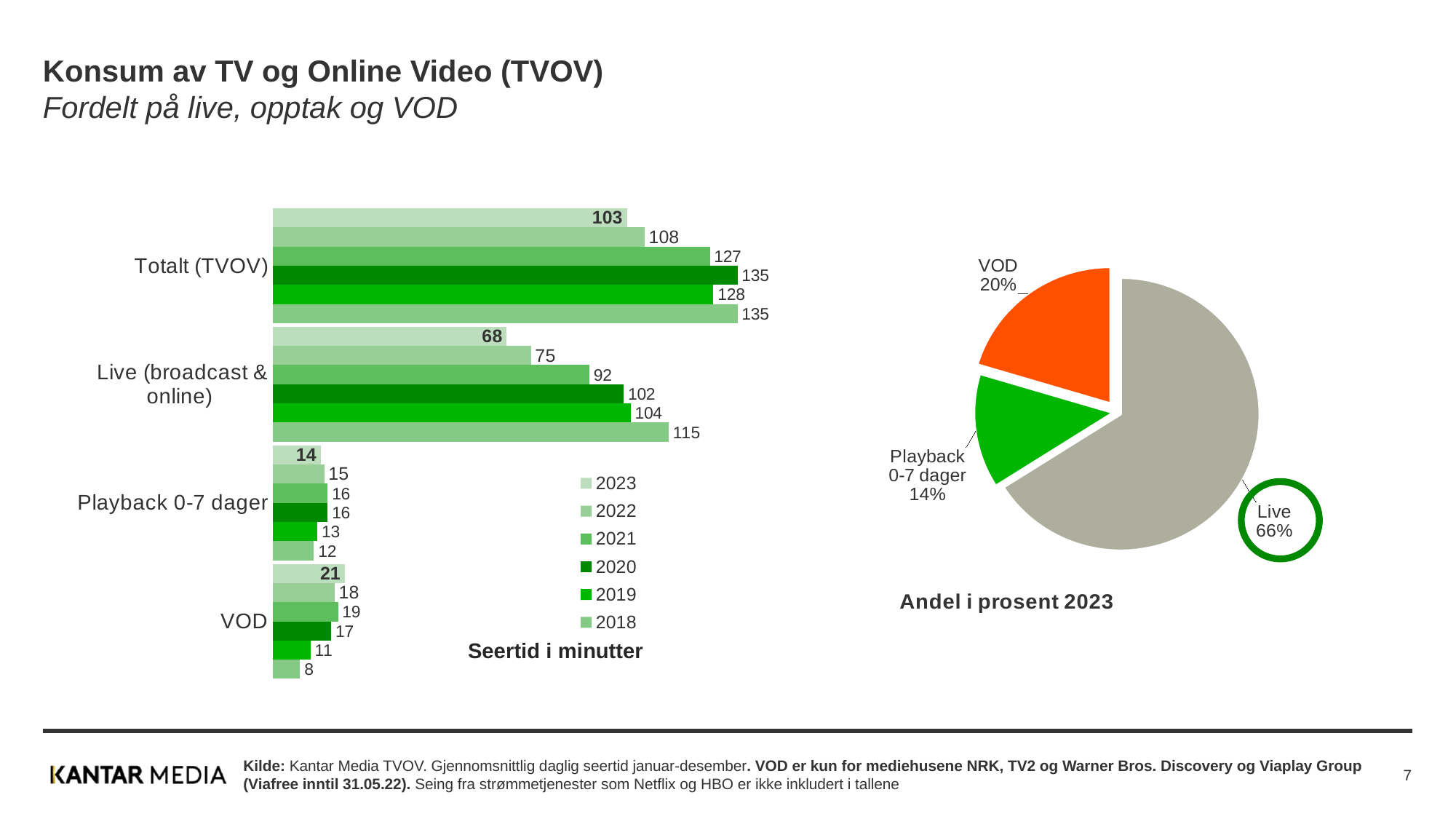
In the bar chart 'Seertid i minutter', which is larger: Playback 0-7 dager in 2023 or VOD in 2023? VOD in 2023 In the bar chart 'Seertid i minutter', how many categories are shown on the vertical axis? 4 In the bar chart 'Seertid i minutter', what is the value for Live (broadcast & online) in 2018? 115 In the bar chart 'Seertid i minutter', does the VOD value rise or fall from 2018 to 2023? rise In the bar chart 'Seertid i minutter', what is the difference between the Live (broadcast & online) values for 2018 and 2023? 47 In the pie chart 'Andel i prosent 2023', what share does Live have? 66% In the bar chart 'Seertid i minutter', which year has the lowest value for Live (broadcast & online)? 2023 In the bar chart 'Seertid i minutter', which year has the highest value for VOD? 2023 In the bar chart 'Seertid i minutter', what is the value for Totalt (TVOV) in 2023? 103 In the bar chart 'Seertid i minutter', what is the value for VOD in 2019? 11 In the bar chart 'Seertid i minutter', how many years does the legend list? 6 What kind of chart is 'Andel i prosent 2023'? pie chart